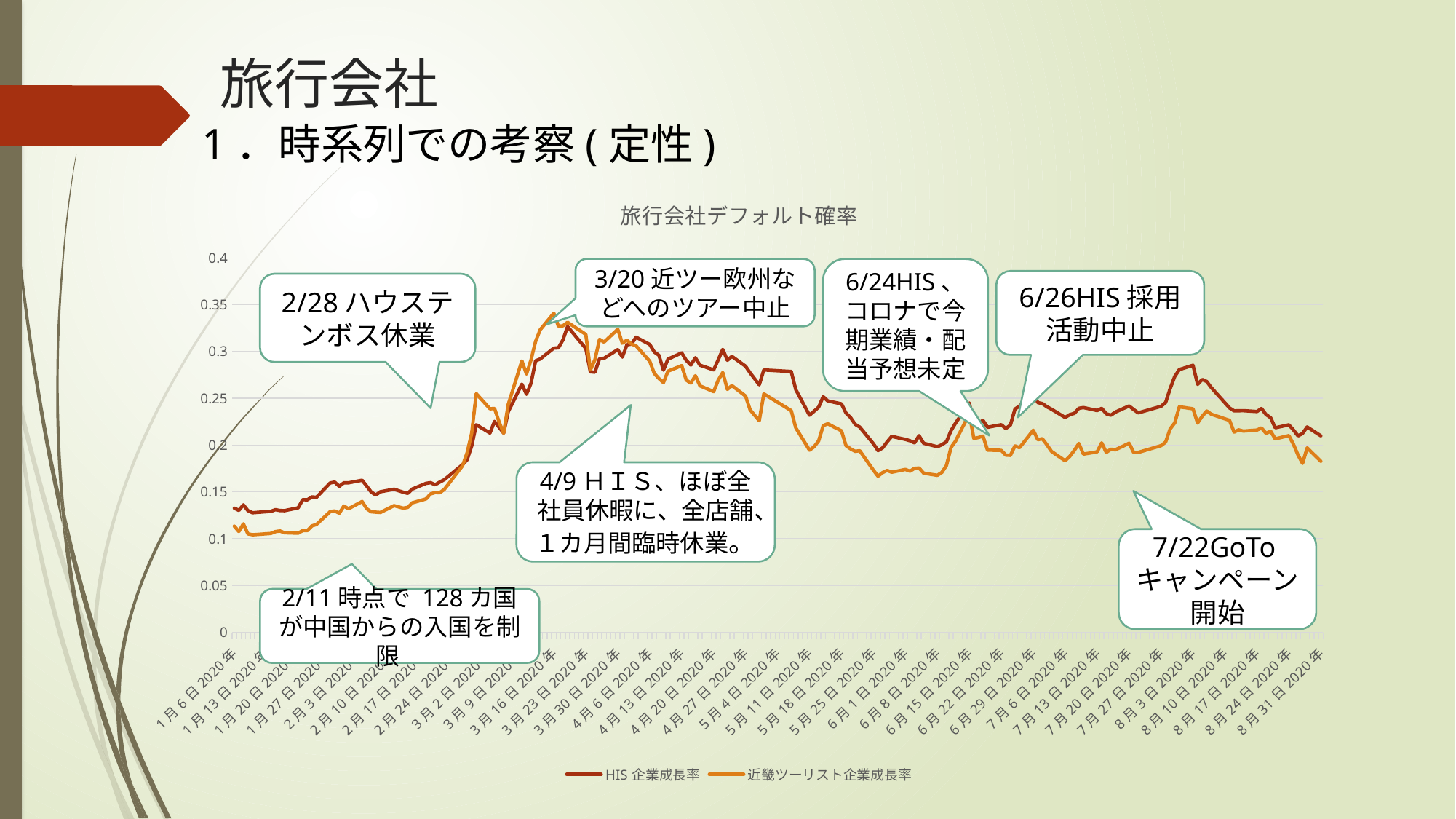
At 8月31日2020年, which series has the higher value, HIS 企業成長率 or 近畿ツーリスト企業成長率? HIS 企業成長率 Do the values of HIS 企業成長率 rise or fall between 2月24日2020年 and 3月16日2020年? rise What is the title of the chart? 旅行会社デフォルト確率 Is the peak value of 近畿ツーリスト企業成長率 in mid-March 2020 greater or less than 0.3? greater How many series does the legend list? 2 What kind of chart is shown on the slide? line chart Is the value for HIS 企業成長率 at 1月6日2020年 greater or less than 0.15? less Which series is drawn in orange according to the legend? 近畿ツーリスト企業成長率 Is the value for 近畿ツーリスト企業成長率 at 8月31日2020年 greater or less than 0.2? less Do the values of 近畿ツーリスト企業成長率 rise or fall between 3月23日2020年 and 6月1日2020年? fall At 1月6日2020年, which series has the higher value, HIS 企業成長率 or 近畿ツーリスト企業成長率? HIS 企業成長率